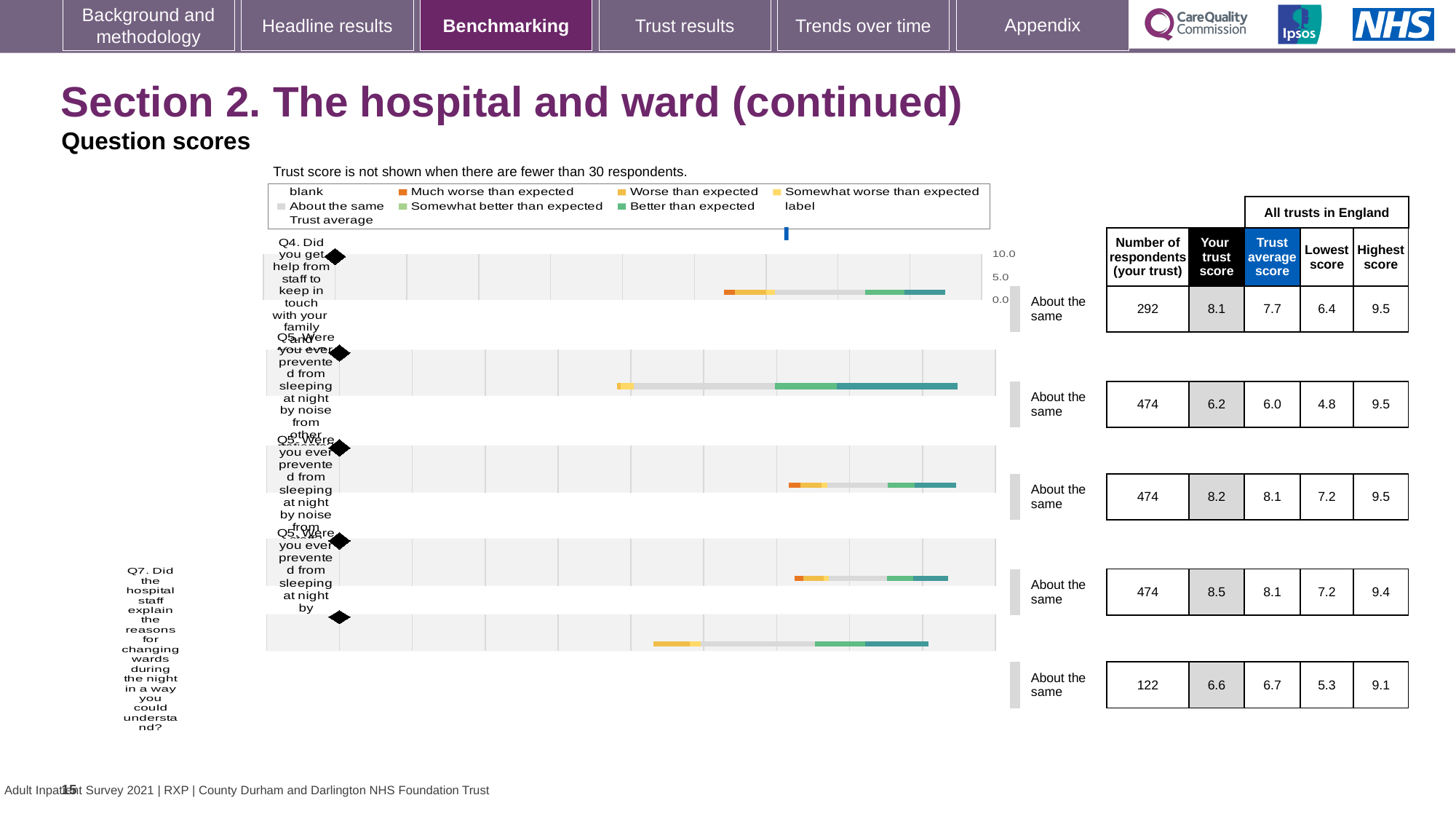
What is the number of respondents for Q7 (explaining reasons for changing wards during the night)? 122 For Q7 (explaining reasons for changing wards), is the trust score higher or lower than the trust average score? Lower What is the lowest score across all trusts in England for the second row of the table (the first Q5 row)? 4.8 Which row of the table has the highest 'Your trust score'? The fourth row (third Q5 row), 8.5 What is the number of respondents for Q4 (help from staff to keep in touch with family) in the table? 292 What is the highest score across all trusts in England for Q7 (explaining reasons for changing wards during the night)? 9.1 What is the difference between the trust score and the trust average score for Q4 (help from staff to keep in touch with family)? 0.4 What benchmark category is shown next to every question on this slide? About the same What is the trust average score for Q4 (help from staff to keep in touch with family)? 7.7 What is the trust score for Q4 (help from staff to keep in touch with family)? 8.1 How many questions (bars) are shown on the chart? 5 Which row of the table has the lowest 'Your trust score'? The second row (first Q5 row), 6.2